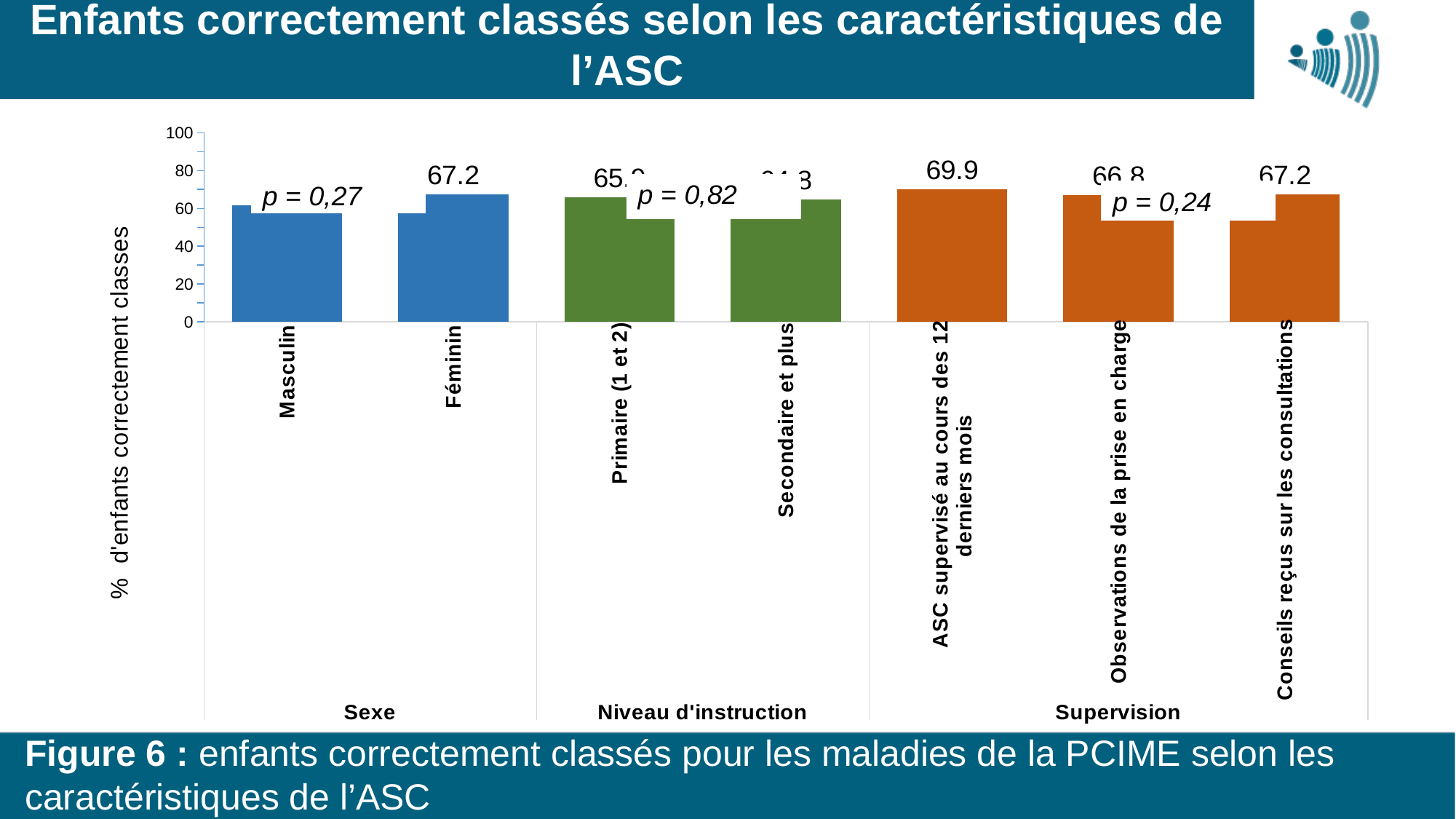
What p-value is shown for the Sexe group? p = 0,27 What is the difference between the values for ASC supervisé au cours des 12 derniers mois and Féminin? 2.7 Which category has the lowest value? Masculin How many bars are plotted on the chart? 7 What is the value for Conseils reçus sur les consultations? 67.2 Is the value for Primaire (1 et 2) greater or less than 40? greater What is the value for ASC supervisé au cours des 12 derniers mois? 69.9 What is the value for Féminin? 67.2 What kind of chart is shown on the slide? bar chart Which category has the highest value? ASC supervisé au cours des 12 derniers mois Is the value for Masculin greater or less than 80? less Which is larger, the value for ASC supervisé au cours des 12 derniers mois or the value for Masculin? ASC supervisé au cours des 12 derniers mois